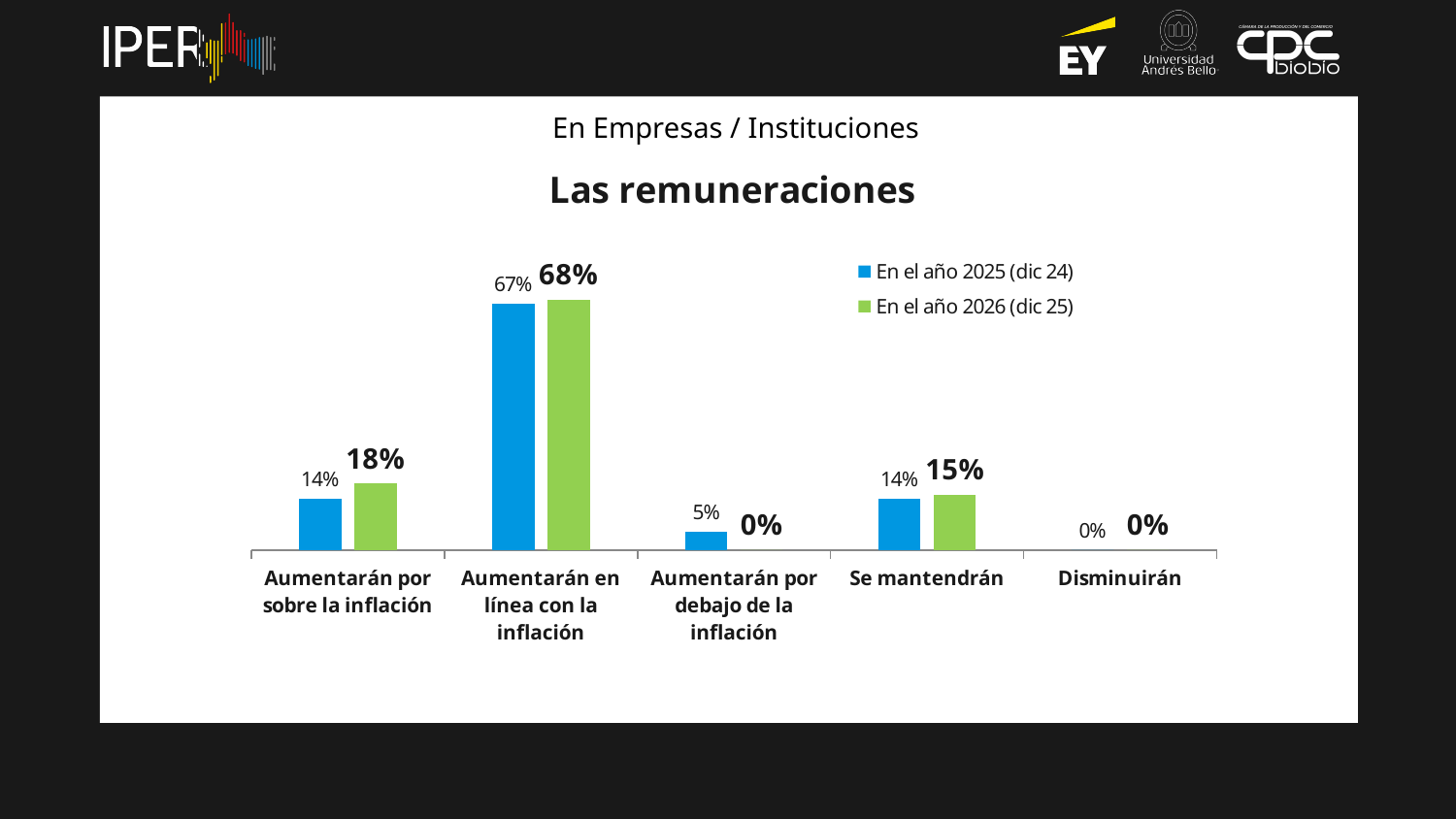
What is the value for "Se mantendrán" in the series "En el año 2026 (dic 25)"? 15% What kind of chart is shown on the slide? Bar chart Which is larger for "Aumentarán por debajo de la inflación": the 2025 (dic 24) value or the 2026 (dic 25) value? En el año 2025 (dic 24) What is the difference between the 2026 (dic 25) and 2025 (dic 24) values for "Aumentarán por sobre la inflación"? 4% What is the title of the chart? Las remuneraciones What is the value for "Aumentarán por sobre la inflación" in the series "En el año 2025 (dic 24)"? 14% How many categories are shown on the x axis? 5 How many series does the legend list? 2 Which category has the highest value in the series "En el año 2025 (dic 24)"? Aumentarán en línea con la inflación What is the value for "Aumentarán en línea con la inflación" in the series "En el año 2026 (dic 25)"? 68% What is the value for "Aumentarán por debajo de la inflación" in the series "En el año 2025 (dic 24)"? 5% Which category has the lowest value in the series "En el año 2025 (dic 24)"? Disminuirán